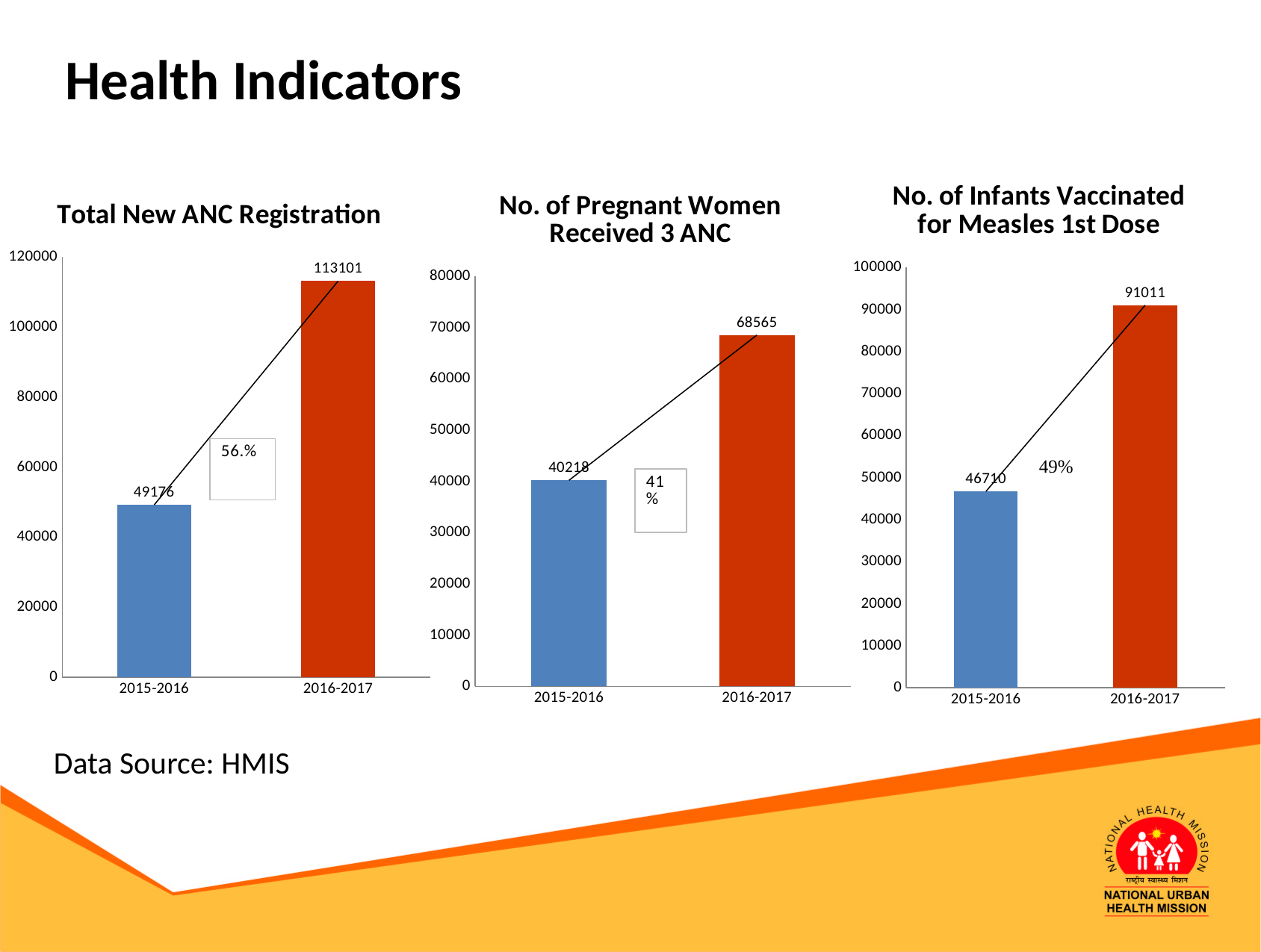
In the 'Total New ANC Registration' chart, what is the value for 2016-2017? 113101 In the 'No. of Pregnant Women Received 3 ANC' chart, what is the value for 2015-2016? 40218 What kind of chart is the 'Total New ANC Registration' chart? Bar chart In the 'No. of Pregnant Women Received 3 ANC' chart, what is the difference between the 2016-2017 and 2015-2016 values? 28347 In the 'Total New ANC Registration' chart, what is the value for 2015-2016? 49176 In the 'Total New ANC Registration' chart, what is the difference between the 2016-2017 and 2015-2016 values? 63925 How many categories are shown on the x axis of the 'No. of Infants Vaccinated for Measles 1st Dose' chart? 2 In the 'No. of Infants Vaccinated for Measles 1st Dose' chart, what is the value for 2016-2017? 91011 In the 'No. of Infants Vaccinated for Measles 1st Dose' chart, what is the difference between the 2016-2017 and 2015-2016 values? 44301 In the 'No. of Pregnant Women Received 3 ANC' chart, do the values rise or fall from 2015-2016 to 2016-2017? Rise In the 'No. of Pregnant Women Received 3 ANC' chart, which year has the lowest value? 2015-2016 In the 'No. of Infants Vaccinated for Measles 1st Dose' chart, which year has the higher value? 2016-2017